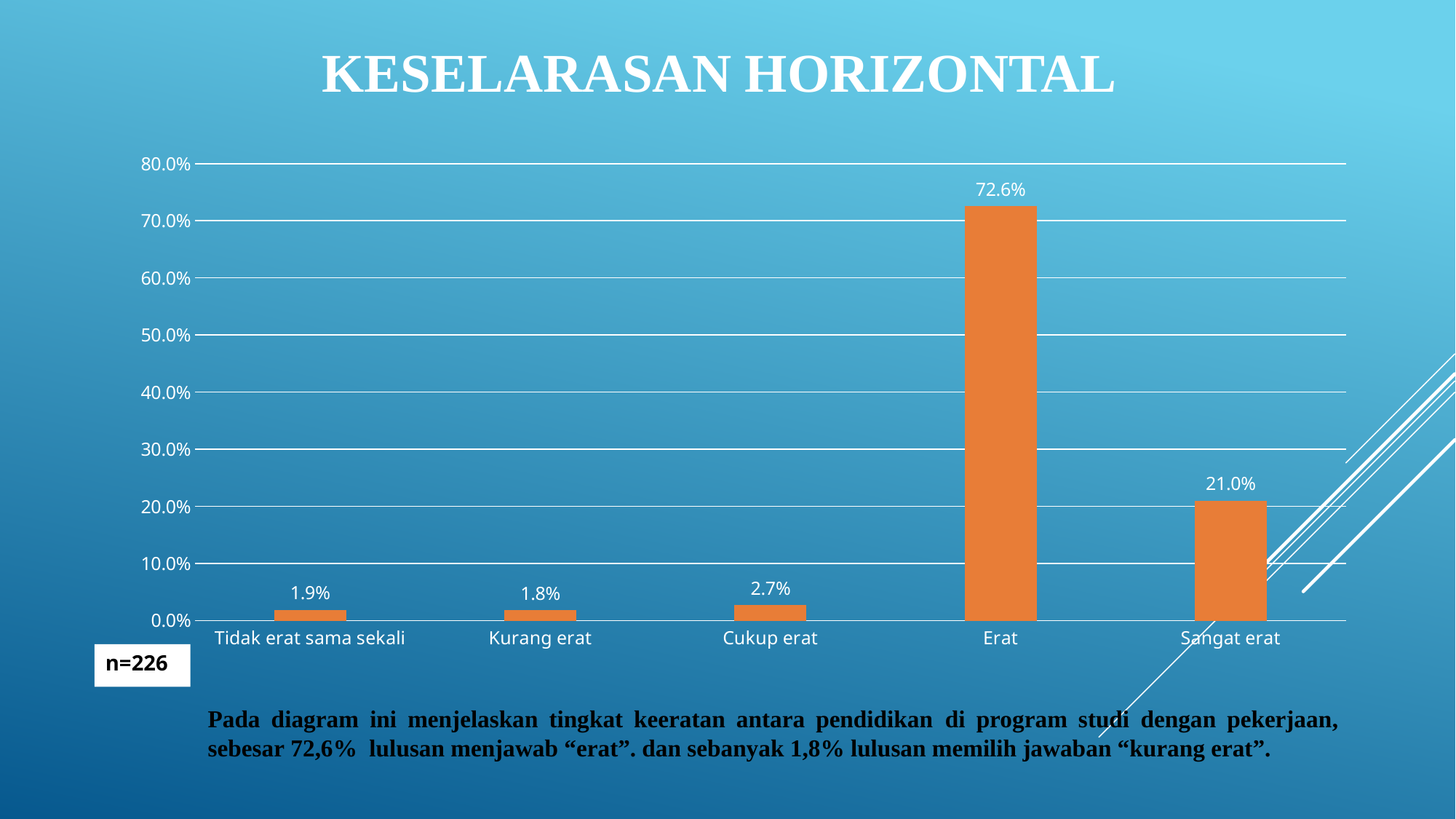
What kind of chart is shown on the slide? Bar chart Which category has the highest value? Erat What is the value for "Erat"? 72.6% What is the value for "Sangat erat"? 21.0% Which is larger, the value for "Cukup erat" or the value for "Tidak erat sama sekali"? Cukup erat How many categories are shown on the x axis? 5 Is the value for "Erat" greater or less than 70.0%? greater Which category has the lowest value? Kurang erat What is the value for "Cukup erat"? 2.7% What is the title of the slide containing the chart? KESELARASAN HORIZONTAL What is the difference between the values for "Erat" and "Sangat erat"? 51.6% What is the value for "Tidak erat sama sekali"? 1.9%